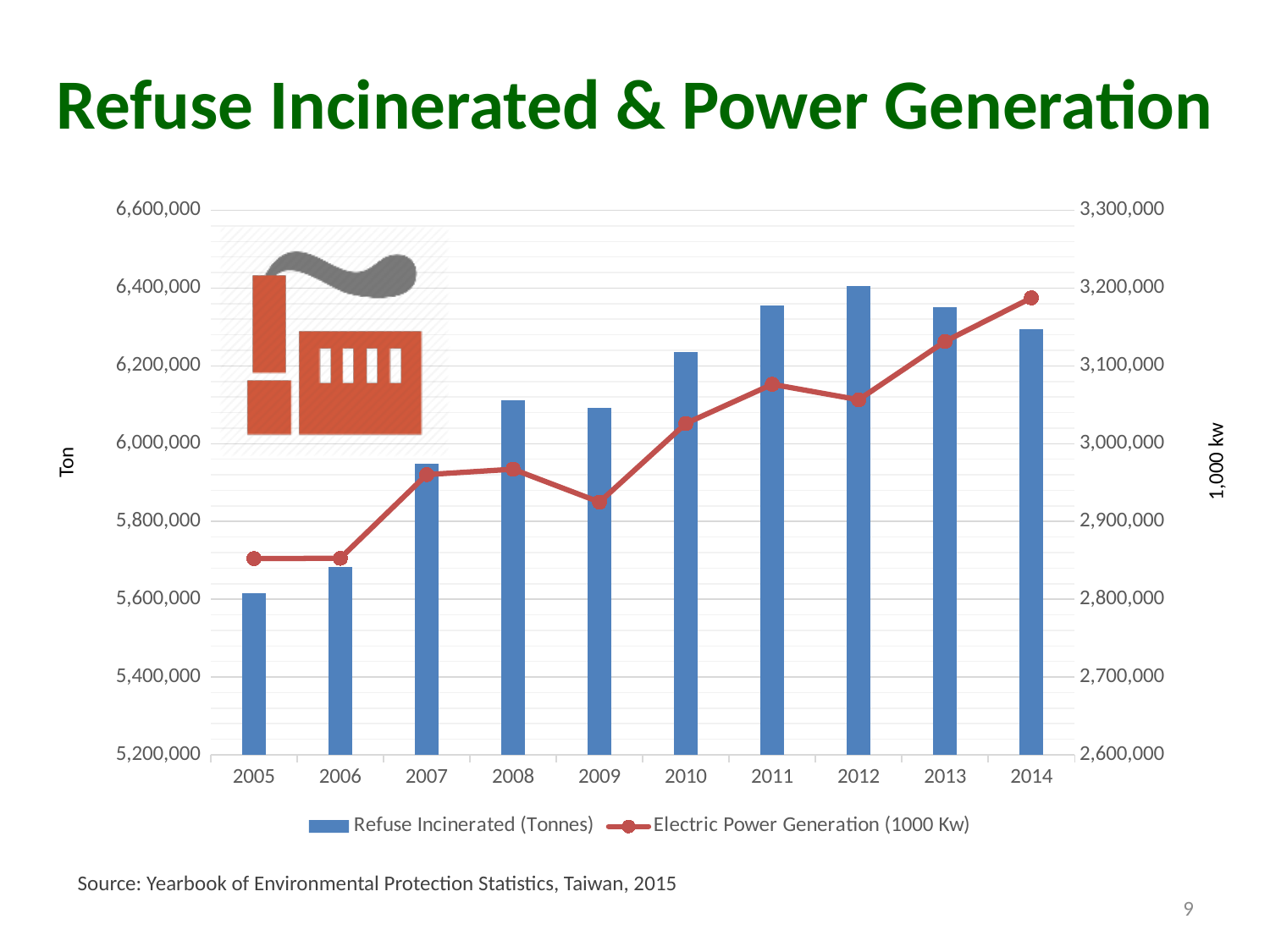
Which year has the highest Electric Power Generation (1000 Kw) value? 2014 Which year has the larger Refuse Incinerated bar, 2009 or 2010? 2010 Is the Electric Power Generation value for 2009 greater or less than 3,000,000? less Which year has the lowest Refuse Incinerated (Tonnes) bar? 2005 Is the Electric Power Generation value for 2014 greater or less than 3,100,000? greater What kind of chart is shown on the slide? A combined bar and line chart How many years are shown on the x axis? 10 Is the Refuse Incinerated value for 2005 greater or less than 5,800,000? less How many series does the legend list? 2 What is the overall trend of Electric Power Generation from 2005 to 2014? Rising Which year has the highest Refuse Incinerated (Tonnes) bar? 2012